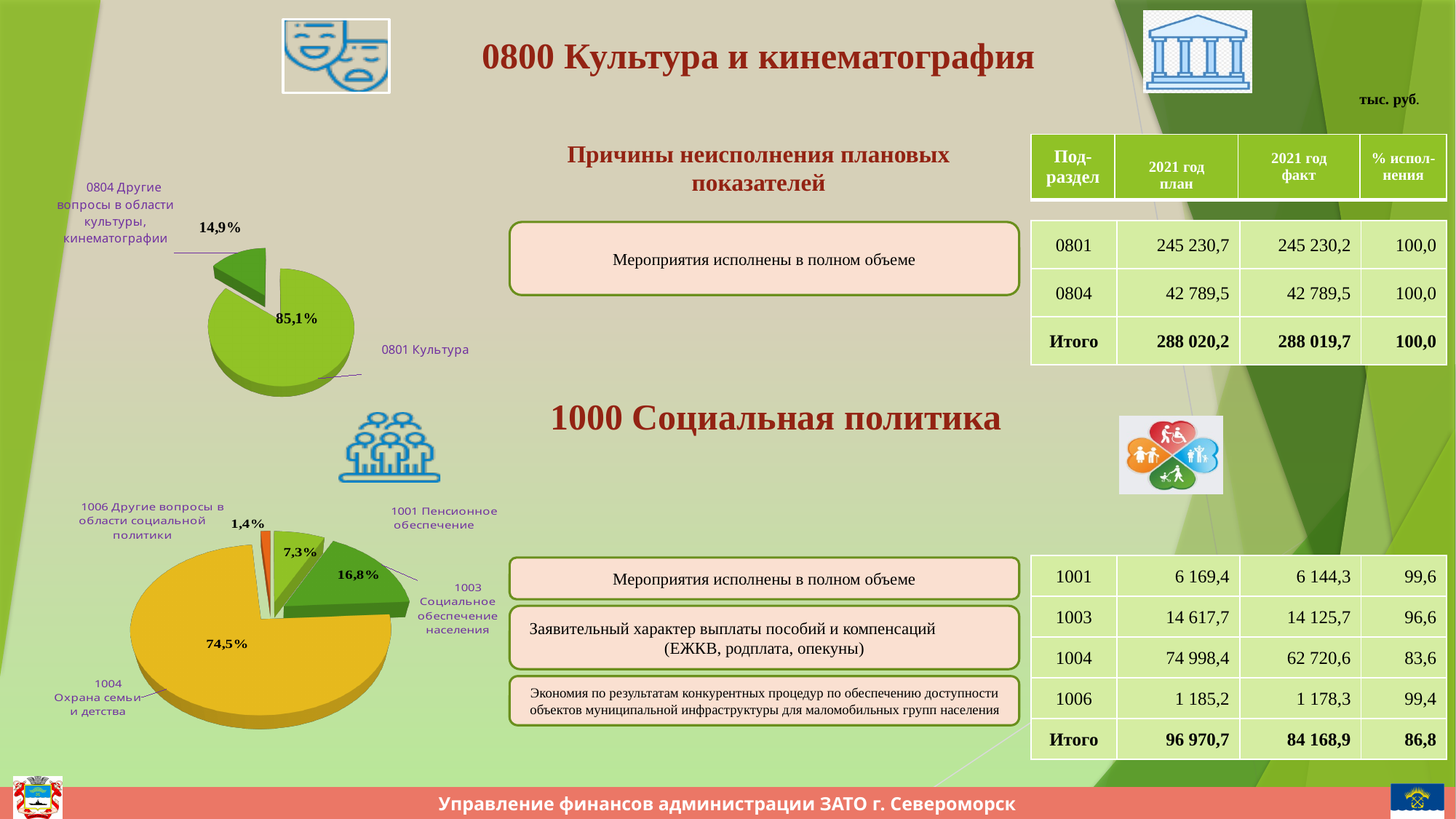
In the upper-left pie chart (0800 Культура и кинематография), what share does 0801 Культура have? 85,1% In the lower-left pie chart (1000 Социальная политика), what is the difference between the shares of 1003 Социальное обеспечение населения and 1001 Пенсионное обеспечение? 9,5% How many slices does the lower-left pie chart (1000 Социальная политика) have? 4 In the upper-left pie chart (0800 Культура и кинематография), which slice is the largest? 0801 Культура In the lower-left pie chart (1000 Социальная политика), which slice is larger: 1001 Пенсионное обеспечение or 1003 Социальное обеспечение населения? 1003 Социальное обеспечение населения How many slices does the upper-left pie chart (0800 Культура и кинематография) have? 2 In the upper-left pie chart (0800 Культура и кинематография), what is the difference between the shares of 0801 Культура and 0804 Другие вопросы? 70,2% In the lower-left pie chart (1000 Социальная политика), what share does 1004 Охрана семьи и детства have? 74,5% In the upper-left pie chart (0800 Культура и кинематография), what share does 0804 Другие вопросы в области культуры, кинематографии have? 14,9% What kind of chart is the upper-left chart on the slide (under 0800 Культура и кинематография)? pie chart In the lower-left pie chart (1000 Социальная политика), which slice is the smallest? 1006 Другие вопросы в области социальной политики